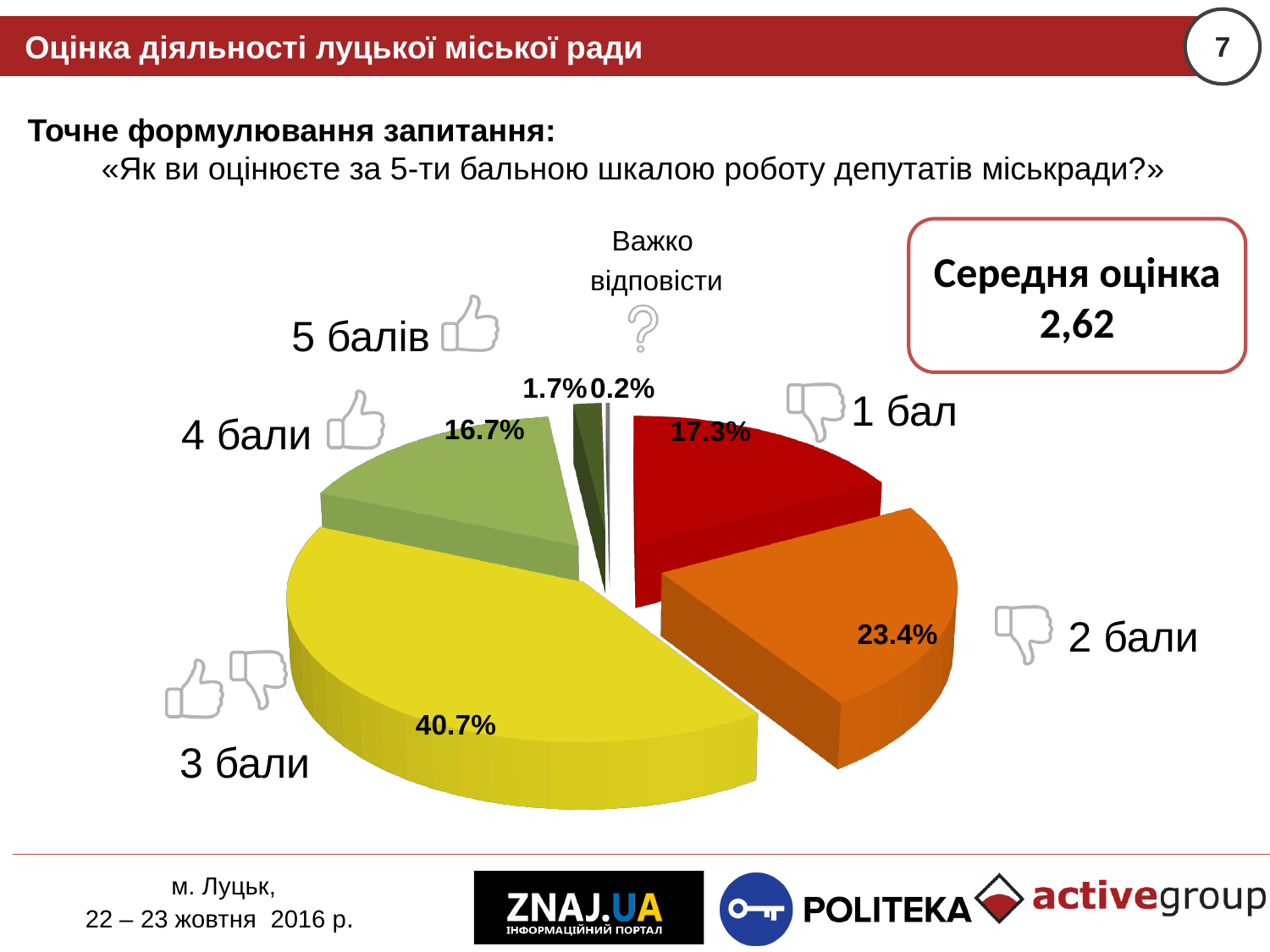
What share of respondents gave a rating of 1 бал? 17.3% What share of respondents gave a rating of 3 бали? 40.7% What average score (Середня оцінка) is shown in the box on the slide? 2,62 What type of chart is shown on the slide? Pie chart Which rating category has the largest slice of the pie? 3 бали What share of respondents gave a rating of 5 балів? 1.7% How many slices does the pie chart have? 6 Which is larger: the share for 4 бали or the share for 1 бал? 1 бал What share of respondents answered «Важко відповісти»? 0.2% What is the difference in percentage points between the shares for 2 бали and 1 бал? 6.1 What share of respondents gave a rating of 2 бали? 23.4% Which category has the smallest slice of the pie? Важко відповісти